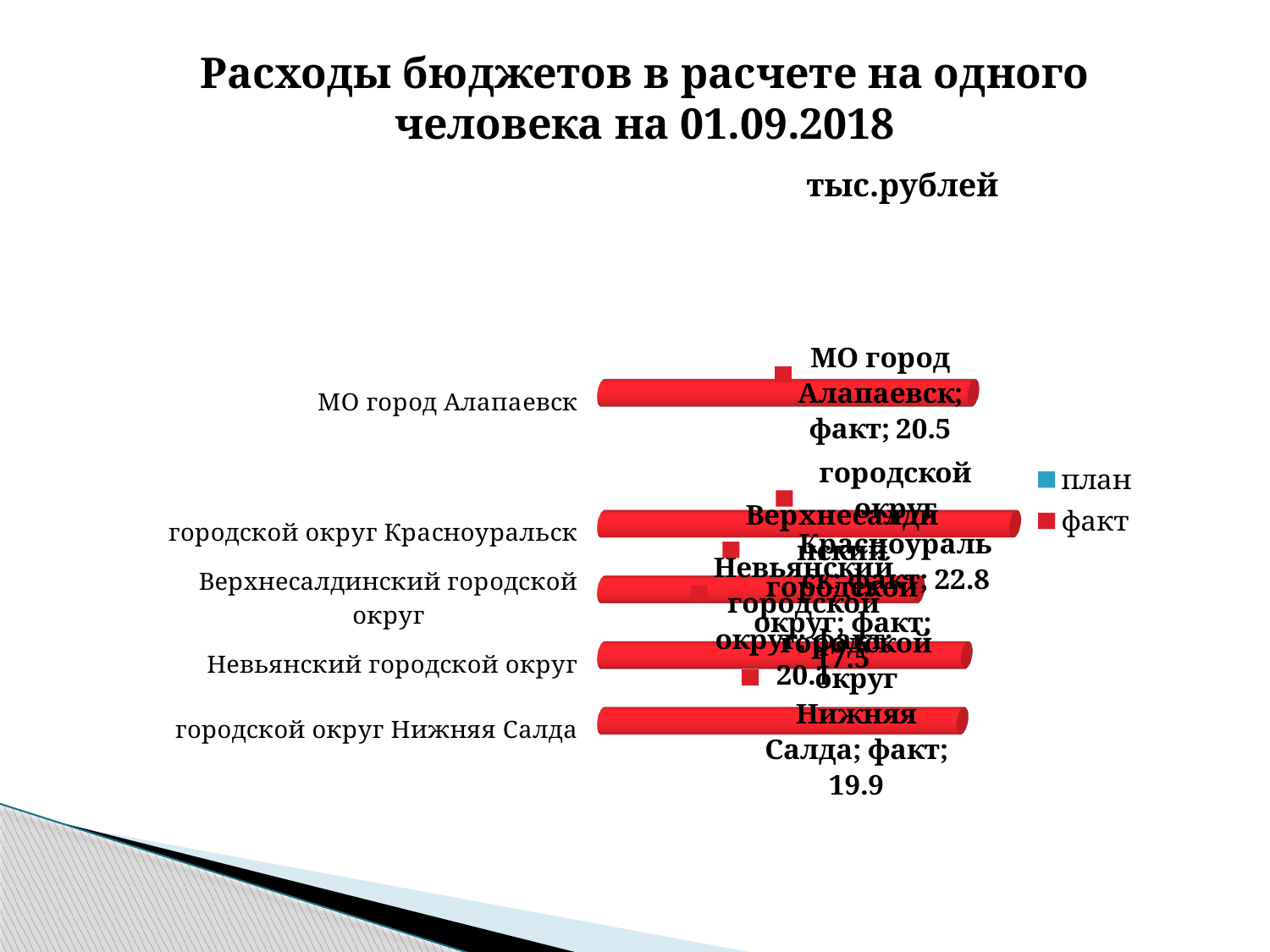
Which has the larger факт value: городской округ Красноуральск or городской округ Нижняя Салда? городской округ Красноуральск What unit is stated for the values in the chart? тыс.рублей What is the difference between the факт values for городской округ Красноуральск and МО город Алапаевск? 2.3 Which category has the shortest факт bar? Верхнесалдинский городской округ What is the difference between the факт values for МО город Алапаевск and городской округ Нижняя Салда? 0.6 What is the факт value for городской округ Красноуральск? 22.8 What is the факт value for городской округ Нижняя Салда? 19.9 Which category has the longest факт bar? городской округ Красноуральск What kind of chart is shown on the slide? bar chart How many series does the legend list? 2 What is the факт value for МО город Алапаевск? 20.5 How many categories are shown in the chart? 5